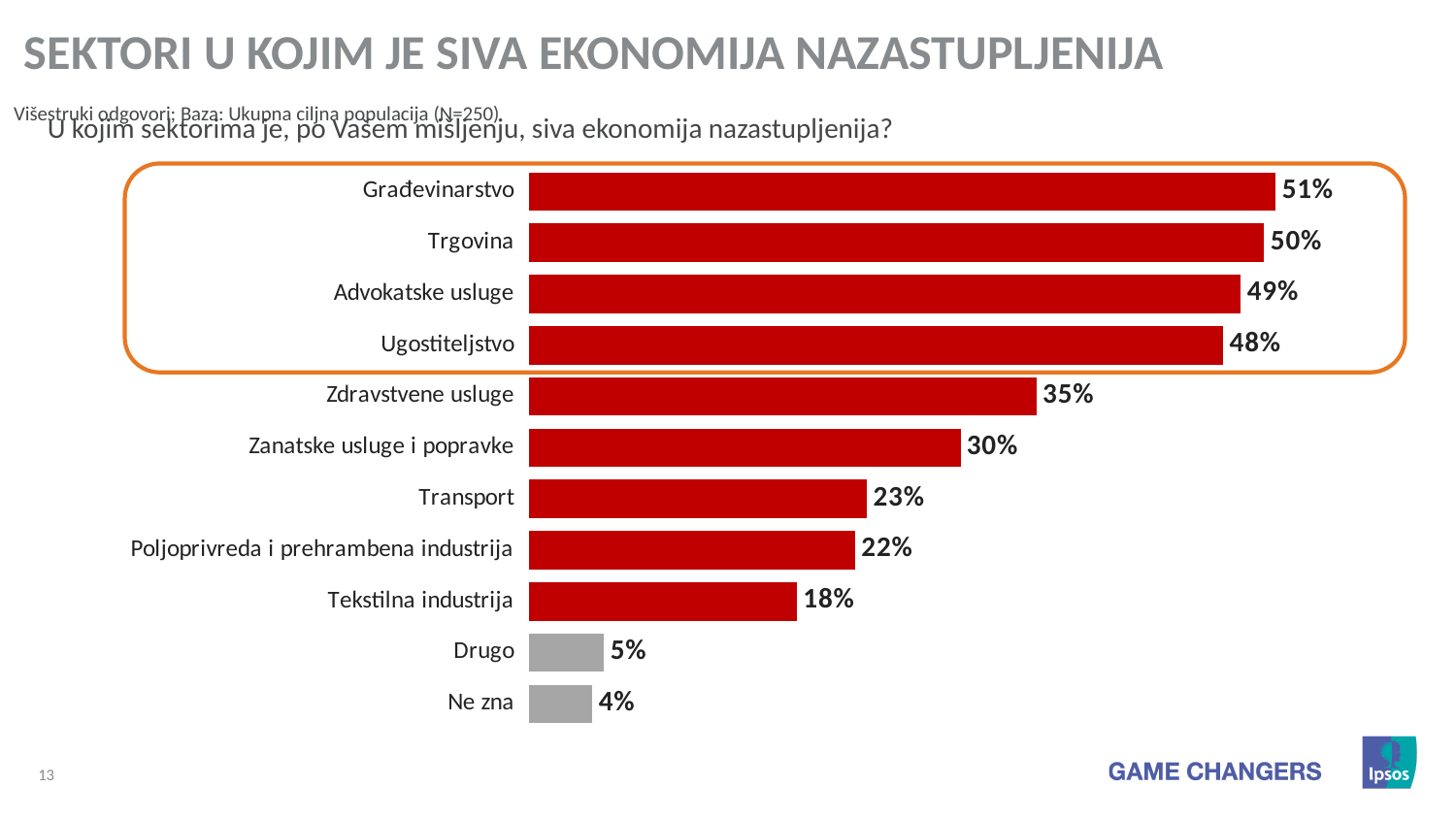
Which categories have grey bars instead of red? Drugo and Ne zna What kind of chart is shown on the slide? Bar chart Which category has the highest value? Građevinarstvo What is the value for Tekstilna industrija? 18% How many categories are shown in the chart? 11 Which category has the lowest value? Ne zna What is the value for Zdravstvene usluge? 35% What is the value for Građevinarstvo? 51% What is the difference between the values for Zanatske usluge i popravke and Poljoprivreda i prehrambena industrija? 8% Which categories are enclosed by the orange outline? Građevinarstvo, Trgovina, Advokatske usluge, Ugostiteljstvo Which is larger, the value for Ugostiteljstvo or the value for Zdravstvene usluge? Ugostiteljstvo What is the difference between the values for Trgovina and Transport? 27%